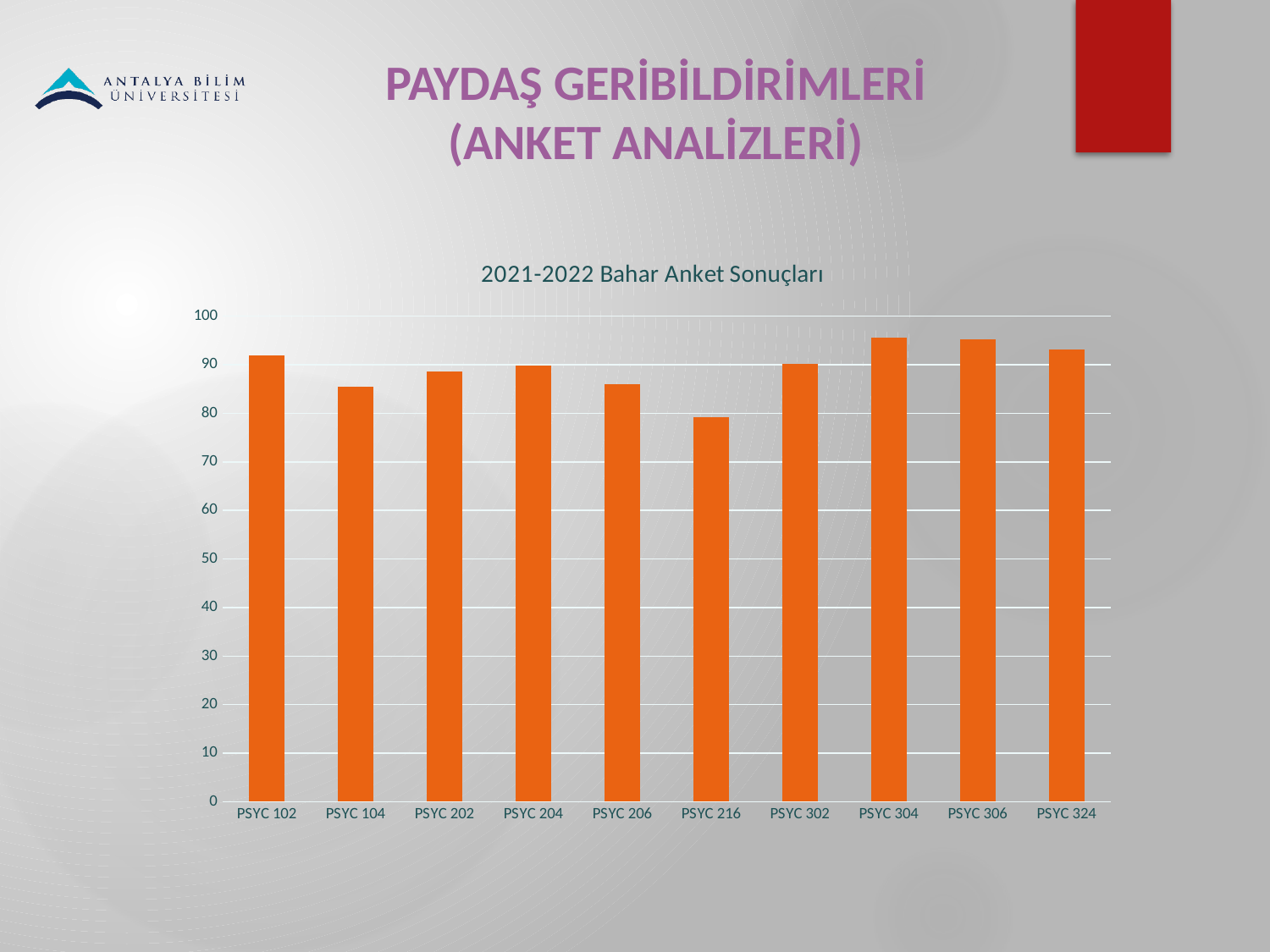
Which has the larger value, PSYC 102 or PSYC 104? PSYC 102 How many courses (categories) are shown on the x axis of the chart? 10 What is the title of the chart? 2021-2022 Bahar Anket Sonuçları Is the value for PSYC 102 greater or less than 90? greater Is the value for PSYC 206 greater or less than 90? less Is the value for PSYC 304 greater or less than 90? greater Which course has the lowest value in the chart? PSYC 216 What kind of chart is shown on the slide? bar chart Which has the larger value, PSYC 216 or PSYC 302? PSYC 302 What colour are the bars in the chart? orange